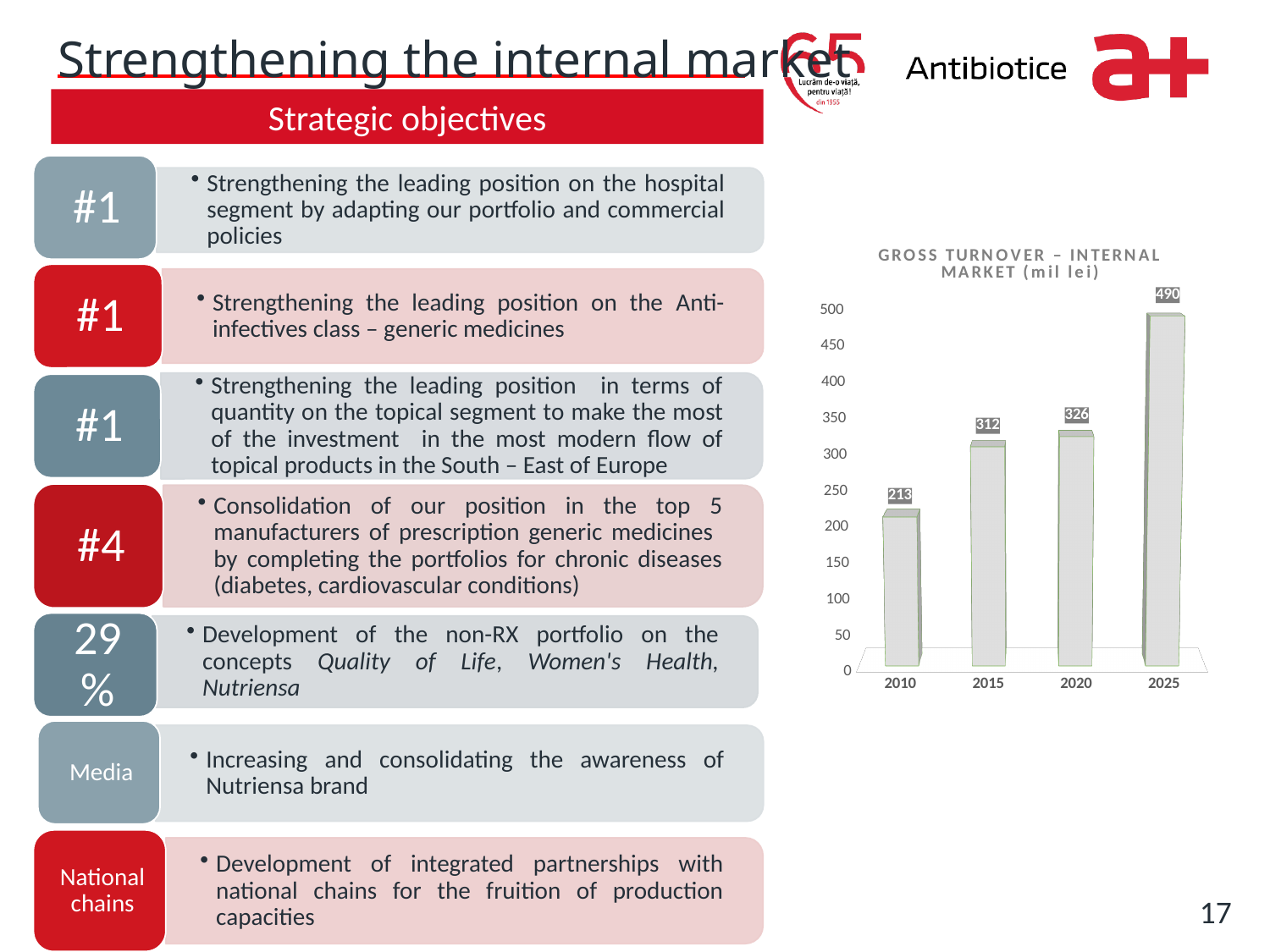
Is the gross turnover for 2020 greater or less than 300? greater How many years are shown on the gross turnover chart? 4 What is the gross turnover on the internal market for 2025? 490 What is the difference in gross turnover between 2015 and 2010? 99 What is the difference in gross turnover between 2025 and 2020? 164 What is the gross turnover on the internal market for 2010? 213 Which year has a larger gross turnover, 2015 or 2020? 2020 Which year has the highest gross turnover on the internal market? 2025 What kind of chart is used to show the gross turnover on the internal market? bar chart What is the gross turnover on the internal market for 2015? 312 Does the gross turnover rise or fall from 2010 to 2025? rise Which year has the lowest gross turnover on the internal market? 2010